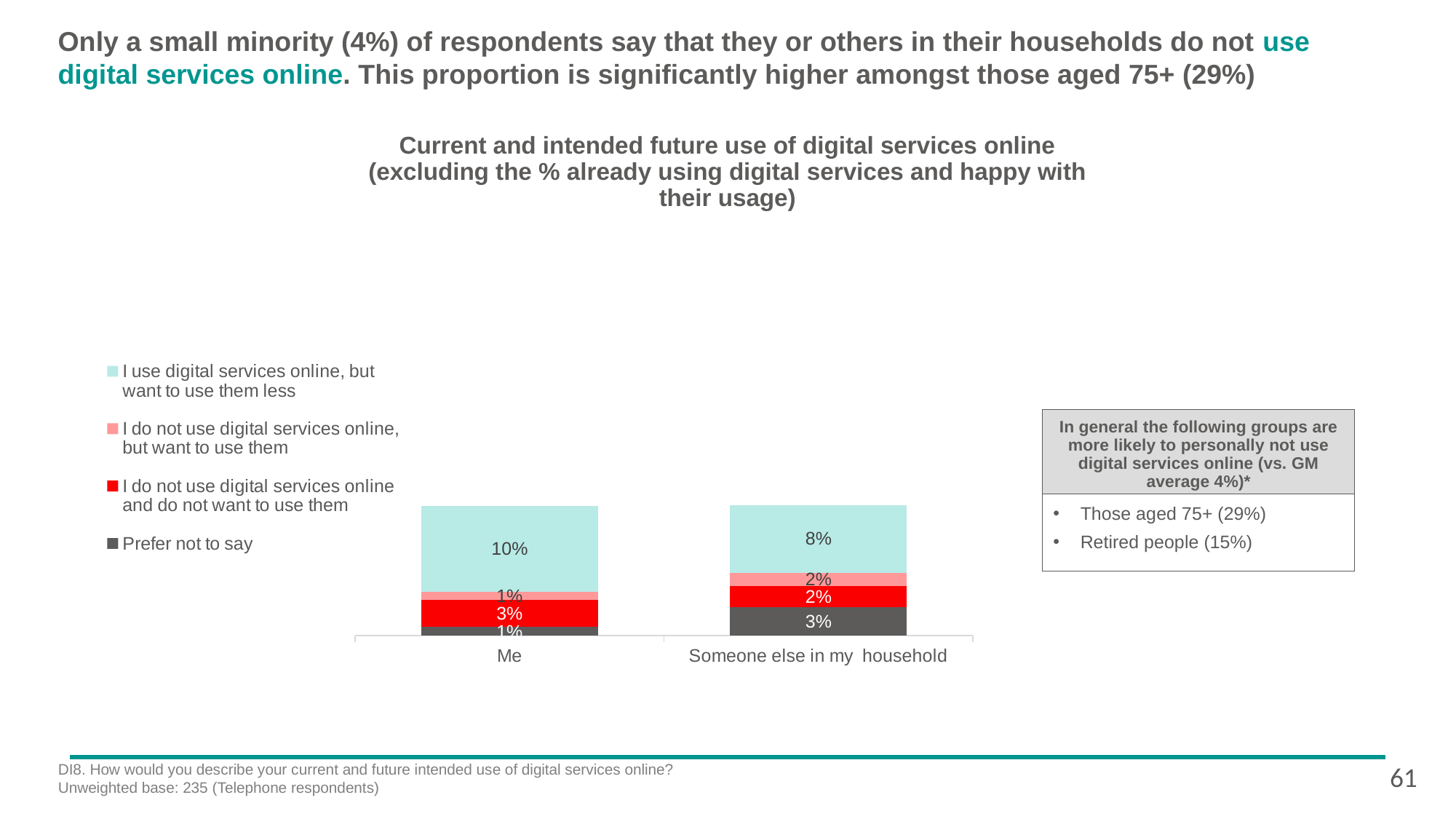
What is the value for 'I use digital services online, but want to use them less' in the 'Someone else in my household' bar? 8% What is the title of the chart? Current and intended future use of digital services online (excluding the % already using digital services and happy with their usage) What is the value for 'I do not use digital services online and do not want to use them' in the 'Me' bar? 3% What is the difference between the 'I use digital services online, but want to use them less' values for 'Me' and 'Someone else in my household'? 2% How many categories are shown on the x axis of the chart? 2 Which category has the larger value for 'I use digital services online, but want to use them less', 'Me' or 'Someone else in my household'? Me What is the value for 'I do not use digital services online, but want to use them' in the 'Someone else in my household' bar? 2% What is the total of the stacked bar for 'Me'? 15% What is the value for 'I use digital services online, but want to use them less' in the 'Me' bar? 10% How many series does the chart's legend list? 4 What kind of chart is shown on the slide? Stacked bar chart What is the value for 'Prefer not to say' in the 'Someone else in my household' bar? 3%